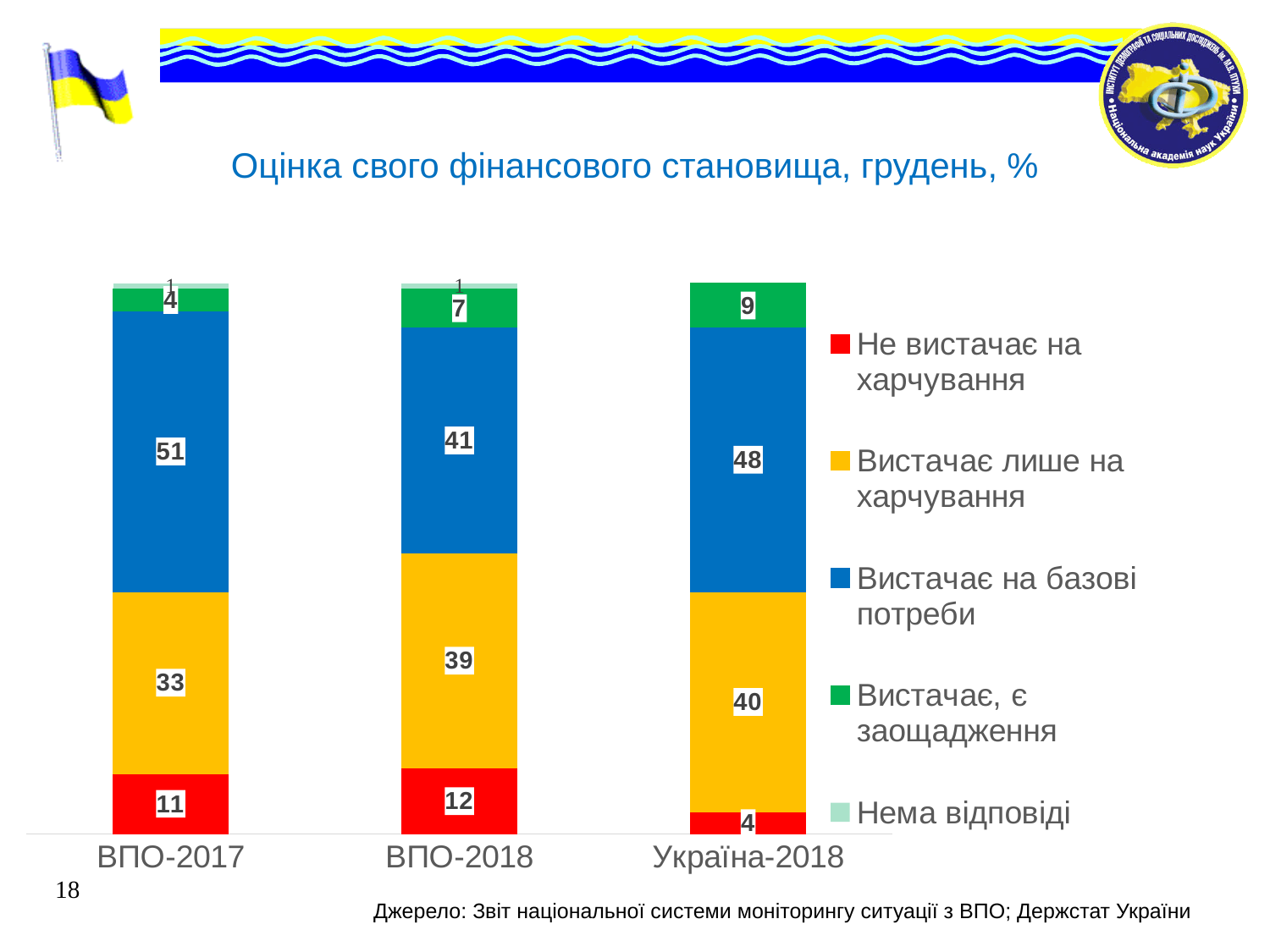
What type of chart is shown on the slide? stacked bar chart How many categories are shown on the x axis? 3 What is the value of 'Вистачає, є заощадження' for Україна-2018? 9 What is the value of 'Не вистачає на харчування' for Україна-2018? 4 Which category has the lowest value for 'Вистачає, є заощадження'? ВПО-2017 What is the title of the chart? Оцінка свого фінансового становища, грудень, % What is the difference between the 'Вистачає на базові потреби' values for ВПО-2017 and ВПО-2018? 10 What is the value of 'Вистачає лише на харчування' for ВПО-2018? 39 What is the value of 'Вистачає на базові потреби' for ВПО-2017? 51 How many series does the legend list? 5 Which is larger: 'Вистачає лише на харчування' for ВПО-2017 or for Україна-2018? Україна-2018 Which category has the highest value for 'Не вистачає на харчування'? ВПО-2018